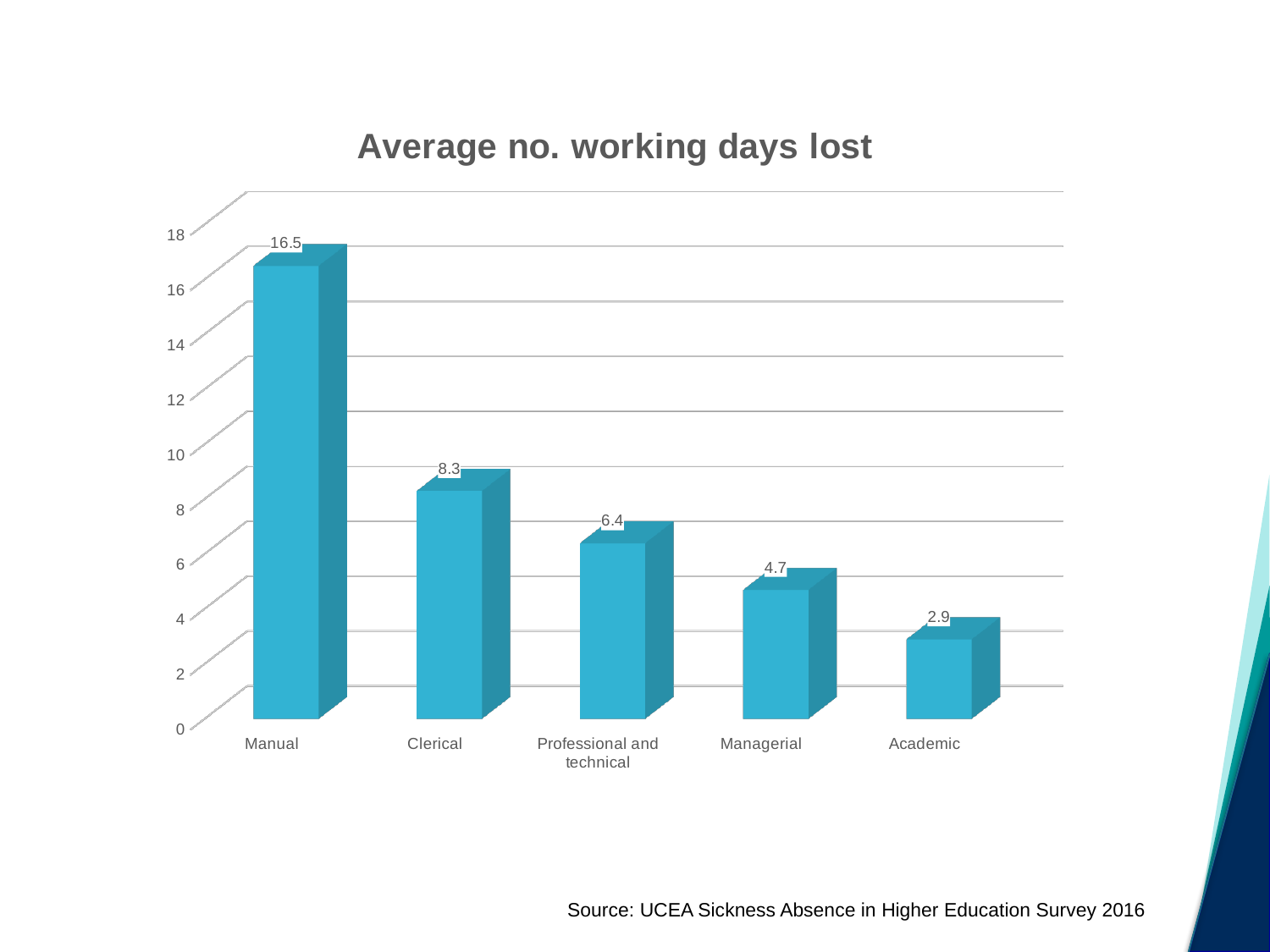
What is the average number of working days lost for Clerical staff? 8.3 Which category has the lowest average number of working days lost? Academic What type of chart is shown on the slide? Bar chart Which category has the highest average number of working days lost? Manual What is the value shown for Academic staff? 2.9 What is the difference between the values for Managerial and Academic? 1.8 How many categories are shown on the chart? 5 Which has a higher value, Clerical or Managerial? Clerical Is the value for Managerial greater or less than 6? less What is the difference between the values for Manual and Clerical? 8.2 What is the average number of working days lost for Manual staff? 16.5 What is the value shown for Professional and technical staff? 6.4